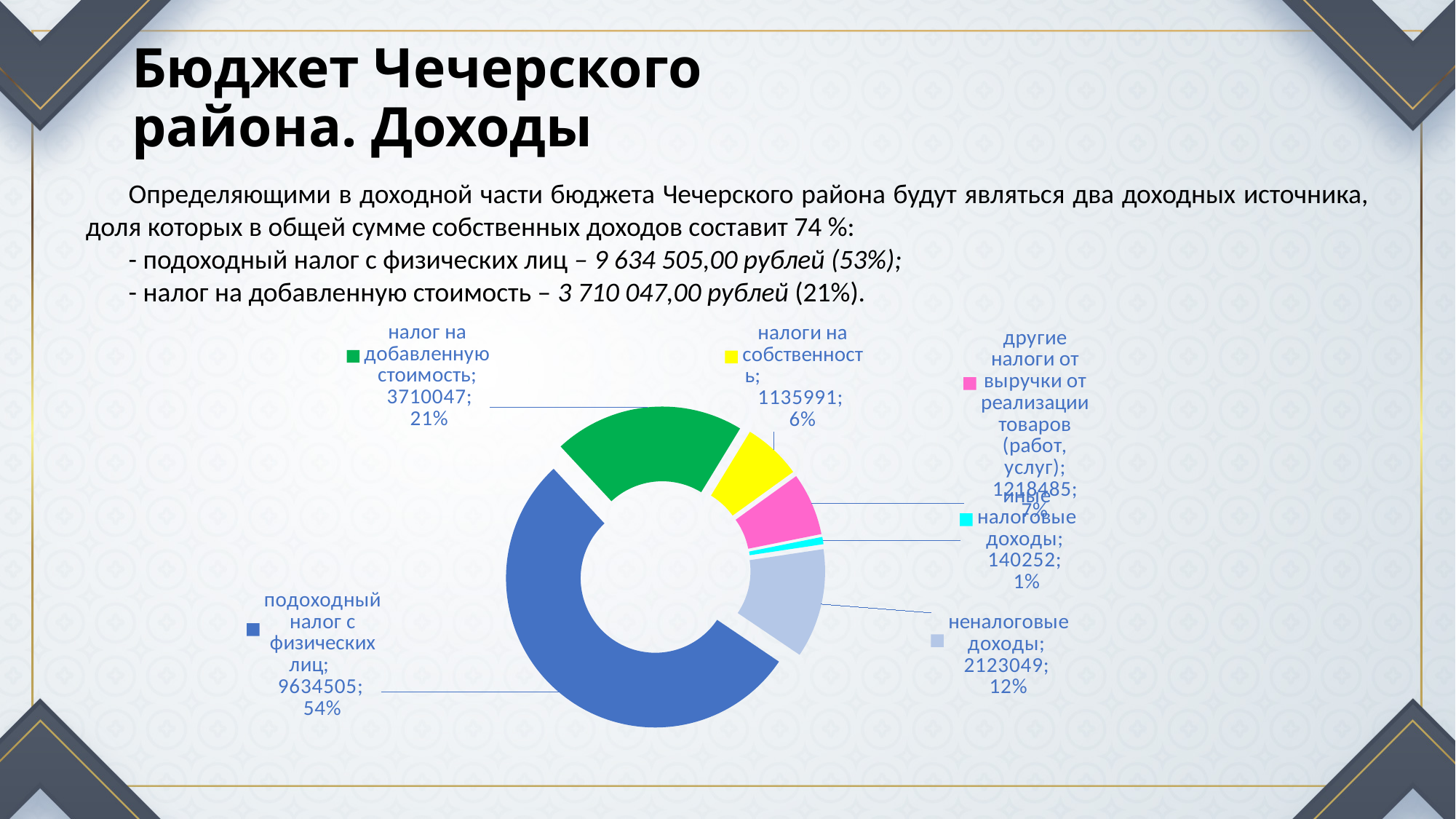
What is the value for иные налоговые доходы? 140252 How many categories does the chart show? 6 What is the value for подоходный налог с физических лиц? 9634505 What is the value for налог на добавленную стоимость? 3710047 What share of the chart does неналоговые доходы take? 12% What colour is the slice for налог на добавленную стоимость? Green What is the difference between the values for налог на добавленную стоимость and неналоговые доходы? 1586998 Which is larger: налоги на собственность or неналоговые доходы? неналоговые доходы What kind of chart is shown on the slide? Doughnut (pie) chart Which category has the largest value? подоходный налог с физических лиц Which category has the smallest value? иные налоговые доходы What share of the chart does подоходный налог с физических лиц take? 54%